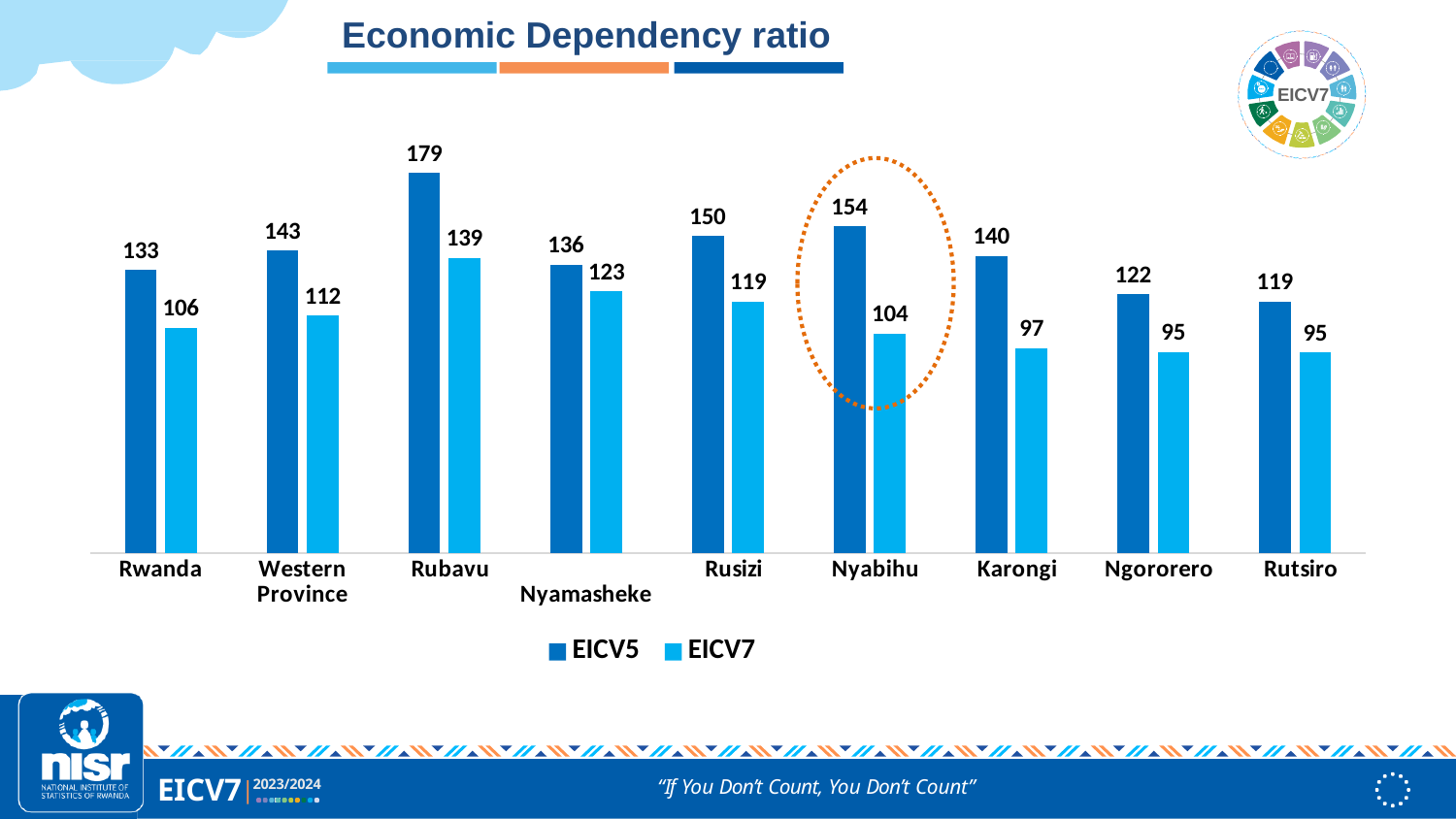
Which is larger, the EICV7 value for Nyamasheke or the EICV7 value for Rusizi? Nyamasheke What is the EICV7 economic dependency ratio for Rubavu? 139 Which category is highlighted with a dotted orange circle? Nyabihu What is the difference between the EICV5 and EICV7 values for Nyabihu? 50 Which categories have the lowest EICV7 value? Ngororero and Rutsiro How many categories are shown on the x axis? 9 What is the EICV7 value for Rwanda? 106 Which category has the highest EICV5 value? Rubavu How many series does the legend list? 2 What is the EICV5 economic dependency ratio for Nyabihu? 154 What kind of chart is shown on the slide? Bar chart What is the title of the chart? Economic Dependency ratio